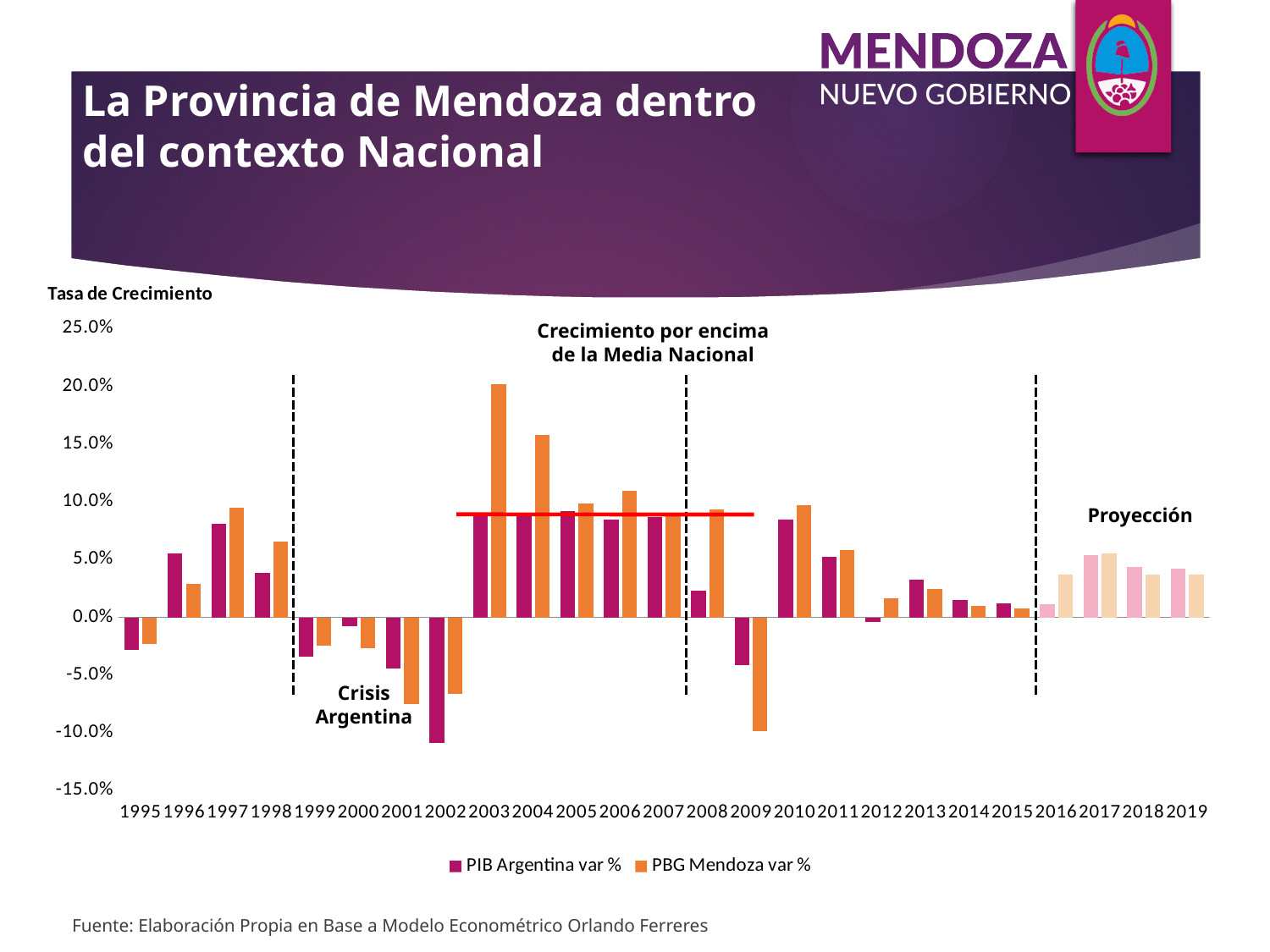
Is the PBG Mendoza var % value for 2003 greater or less than 15.0%? greater Is the PIB Argentina var % value for 2002 greater or less than -5.0%? less In which year is the PBG Mendoza var % value highest? 2003 In which year is the PBG Mendoza var % value lowest? 2009 How many years are shown on the x axis? 25 What kind of chart is shown on the slide? Bar chart Does the PIB Argentina var % value rise or fall from 2010 to 2012? Fall What are the two series named in the legend? PIB Argentina var % and PBG Mendoza var % In which year is the PIB Argentina var % value lowest? 2002 How many series does the legend list? 2 Is the PBG Mendoza var % value for 2009 greater or less than -5.0%? less In 2008, which is larger: PIB Argentina var % or PBG Mendoza var %? PBG Mendoza var %